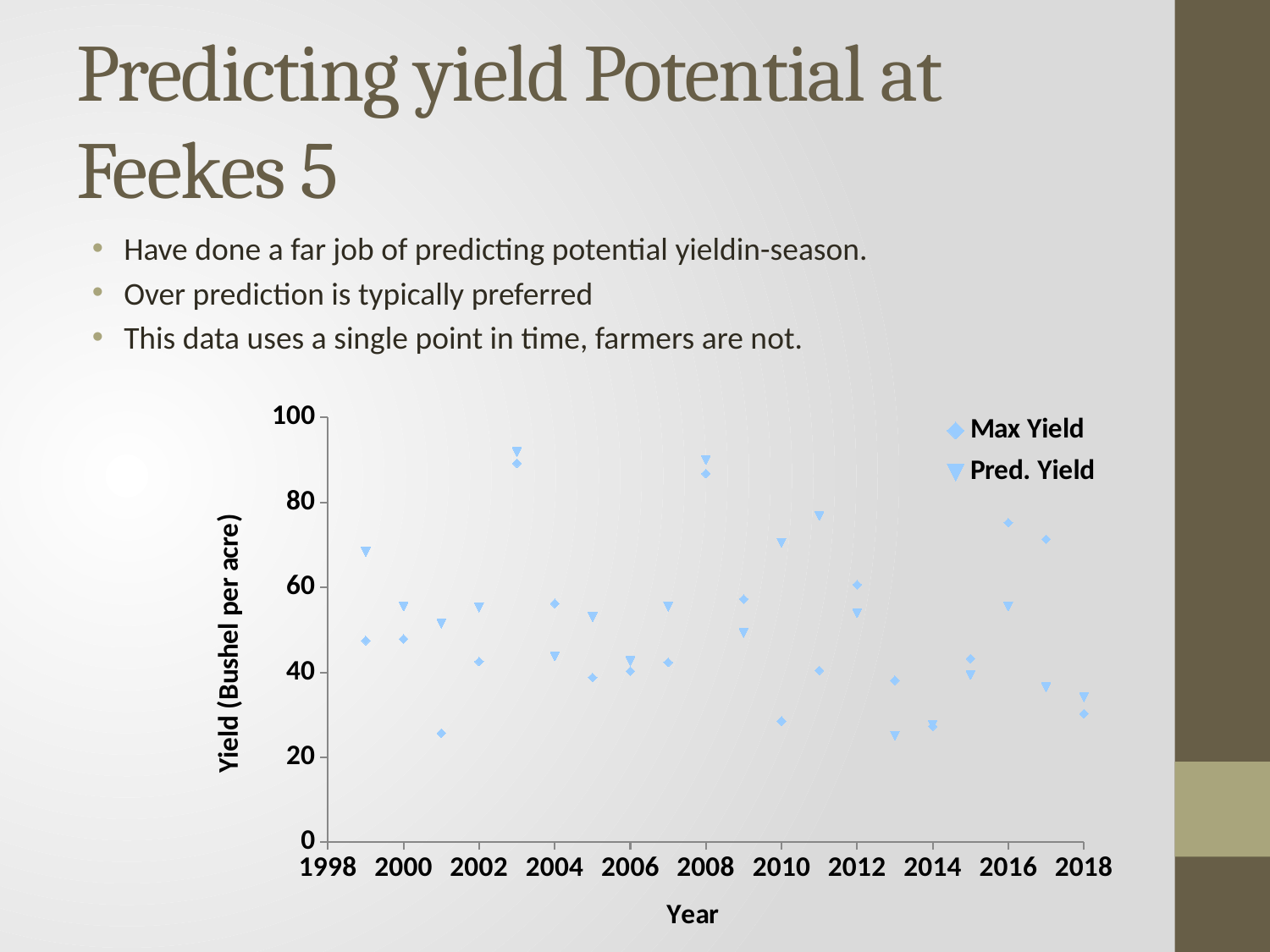
Is the Pred. Yield value for 1999 greater or less than 60? greater What is the label of the vertical axis of the chart? Yield (Bushel per acre) What type of chart is shown on the slide? scatter chart What are the two series named in the chart legend? Max Yield and Pred. Yield How many series does the chart legend list? 2 Is the Max Yield value for 2016 greater or less than 60? greater In 2010, which is larger: Max Yield or Pred. Yield? Pred. Yield In 2016, which is larger: Max Yield or Pred. Yield? Max Yield Is the Max Yield value for 2003 greater or less than 80? greater In 1999, which is larger: Max Yield or Pred. Yield? Pred. Yield